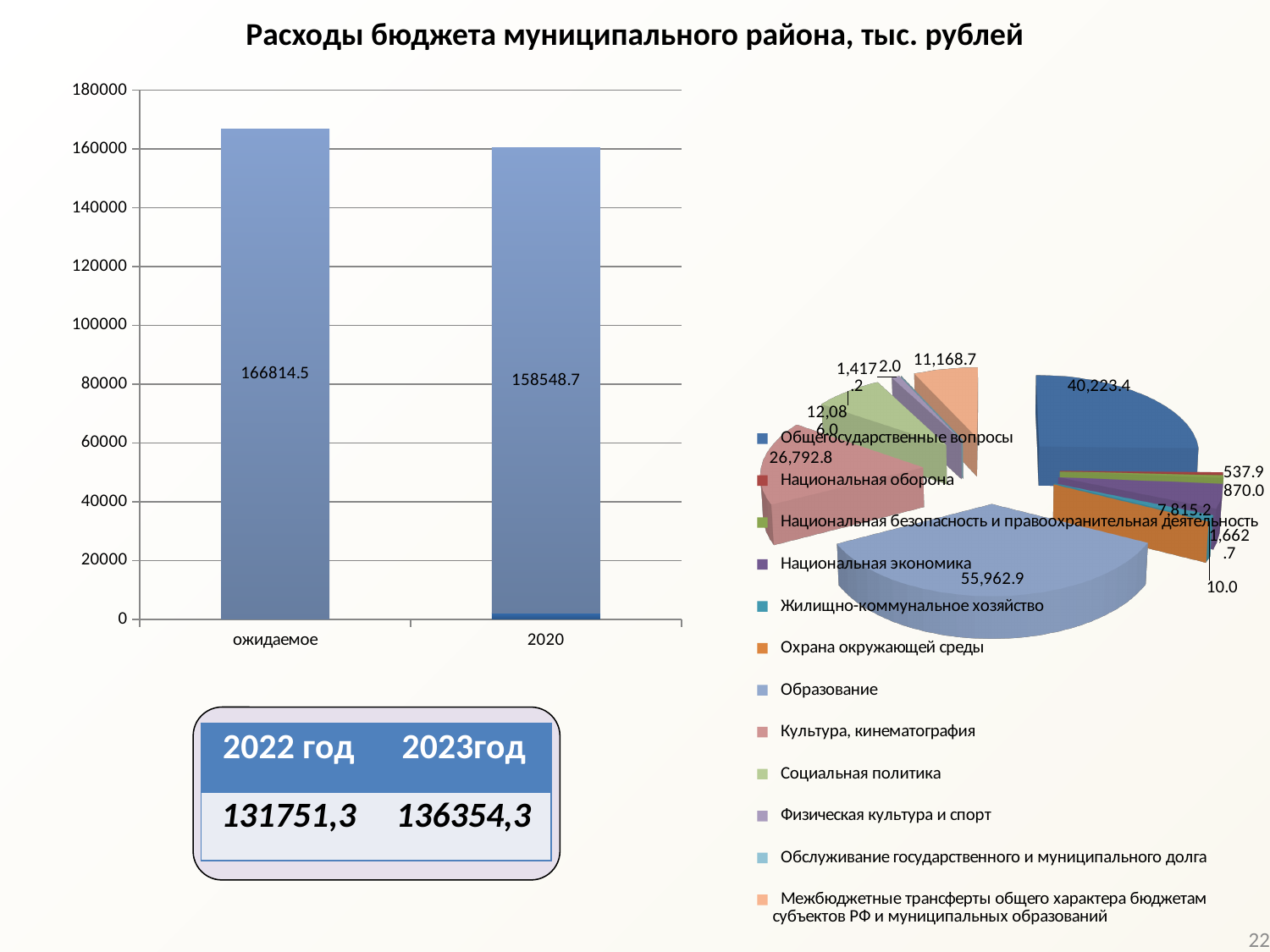
What kind of chart is on the left side of the slide? bar chart In the bar chart on the left, is the value for 'ожидаемое' greater or less than 160000? greater In the pie chart on the right, what is the value for 'Образование'? 55,962.9 In the pie chart on the right, what is the value for 'Общегосударственные вопросы'? 40,223.4 In the bar chart on the left, what is the difference between the values for 'ожидаемое' and '2020'? 8265.8 How many categories are shown in the bar chart on the left? 2 In the bar chart on the left, which category has the higher value, 'ожидаемое' or '2020'? ожидаемое What kind of chart is on the right side of the slide? pie chart In the bar chart on the left, what is the value for '2020'? 158548.7 In the bar chart on the left, what is the value for 'ожидаемое'? 166814.5 In the pie chart on the right, which category has the largest slice? Образование How many entries does the legend of the pie chart on the right list? 12